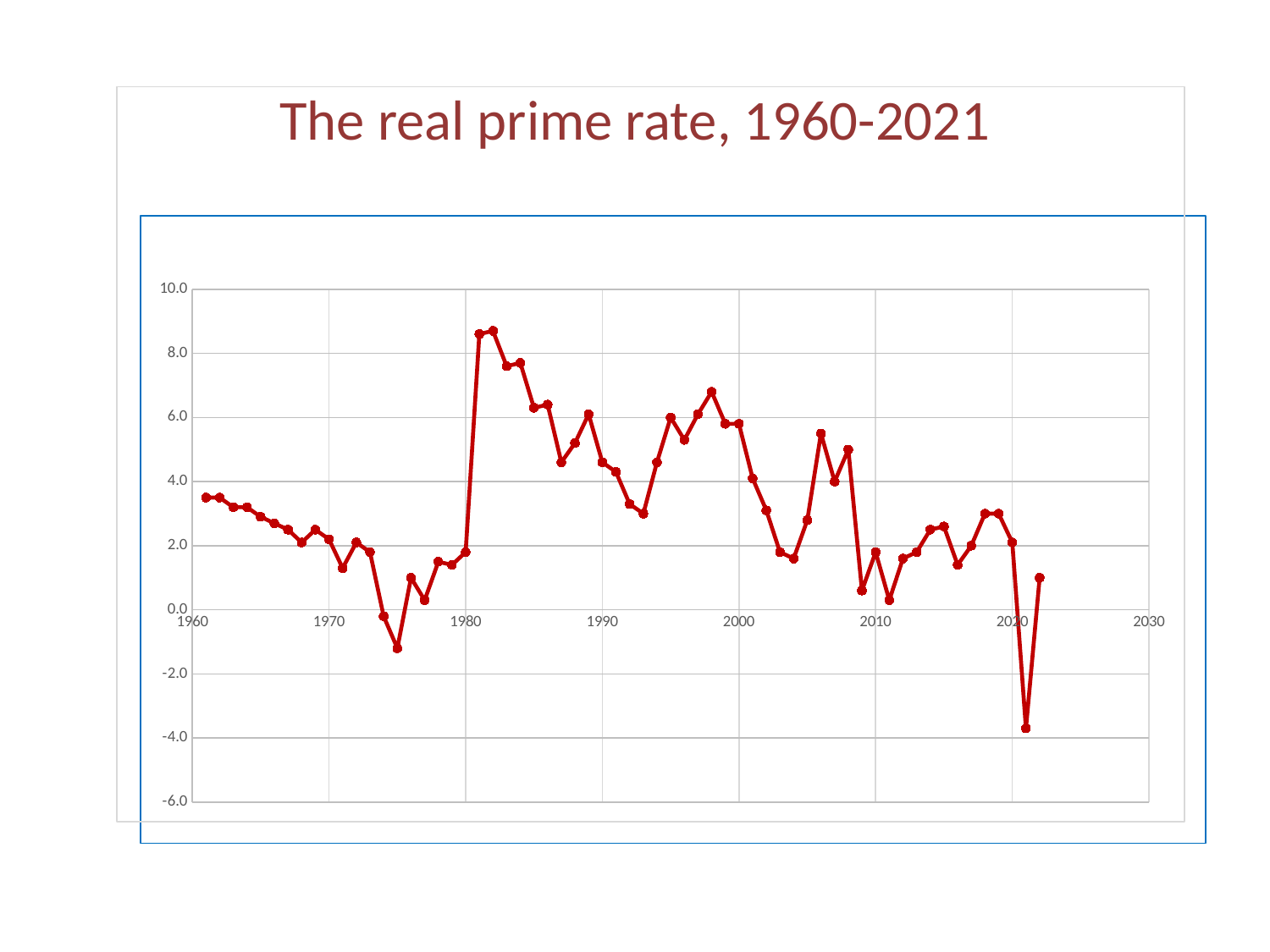
Is the lowest value on the chart greater or less than -2.0? less Is the highest value on the chart greater or less than 8.0? greater Is the value for 1975 greater or less than 0.0? less In which decade does the highest value on the chart occur? 1980s Which is larger, the value for 1981 or the value for 2021? 1981 What is the title of the chart? The real prime rate, 1960-2021 What colour is the line plotted on the chart? red What kind of chart is shown on the slide? line chart Between 1961 and 1975, do the values generally rise or fall? fall